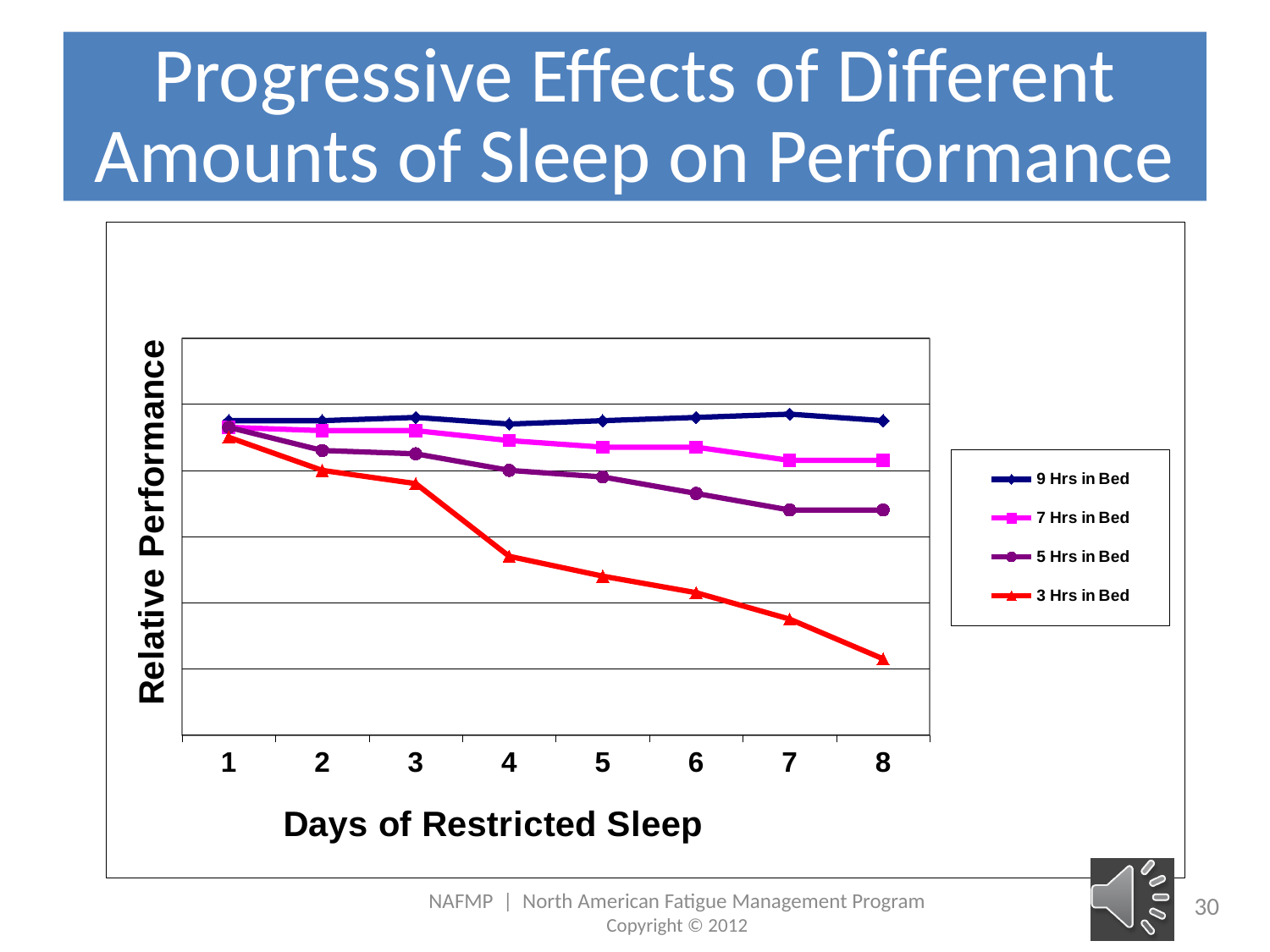
On day 8, which is higher: the relative performance for 7 Hrs in Bed or for 5 Hrs in Bed? 7 Hrs in Bed On day 4, which is higher: the relative performance for 5 Hrs in Bed or for 3 Hrs in Bed? 5 Hrs in Bed Which series has the lowest relative performance on day 8? 3 Hrs in Bed What is the label of the x axis? Days of Restricted Sleep Which series shows the steepest decline over the 8 days? 3 Hrs in Bed How many days of restricted sleep are plotted along the x axis? 8 What kind of chart is shown on the slide? line chart Does the relative performance for 5 Hrs in Bed rise or fall from day 1 to day 8? fall How many series does the legend list? 4 What is the label of the y axis? Relative Performance Which series has the highest relative performance on day 8? 9 Hrs in Bed Does the relative performance for 3 Hrs in Bed rise or fall as the days of restricted sleep increase? fall